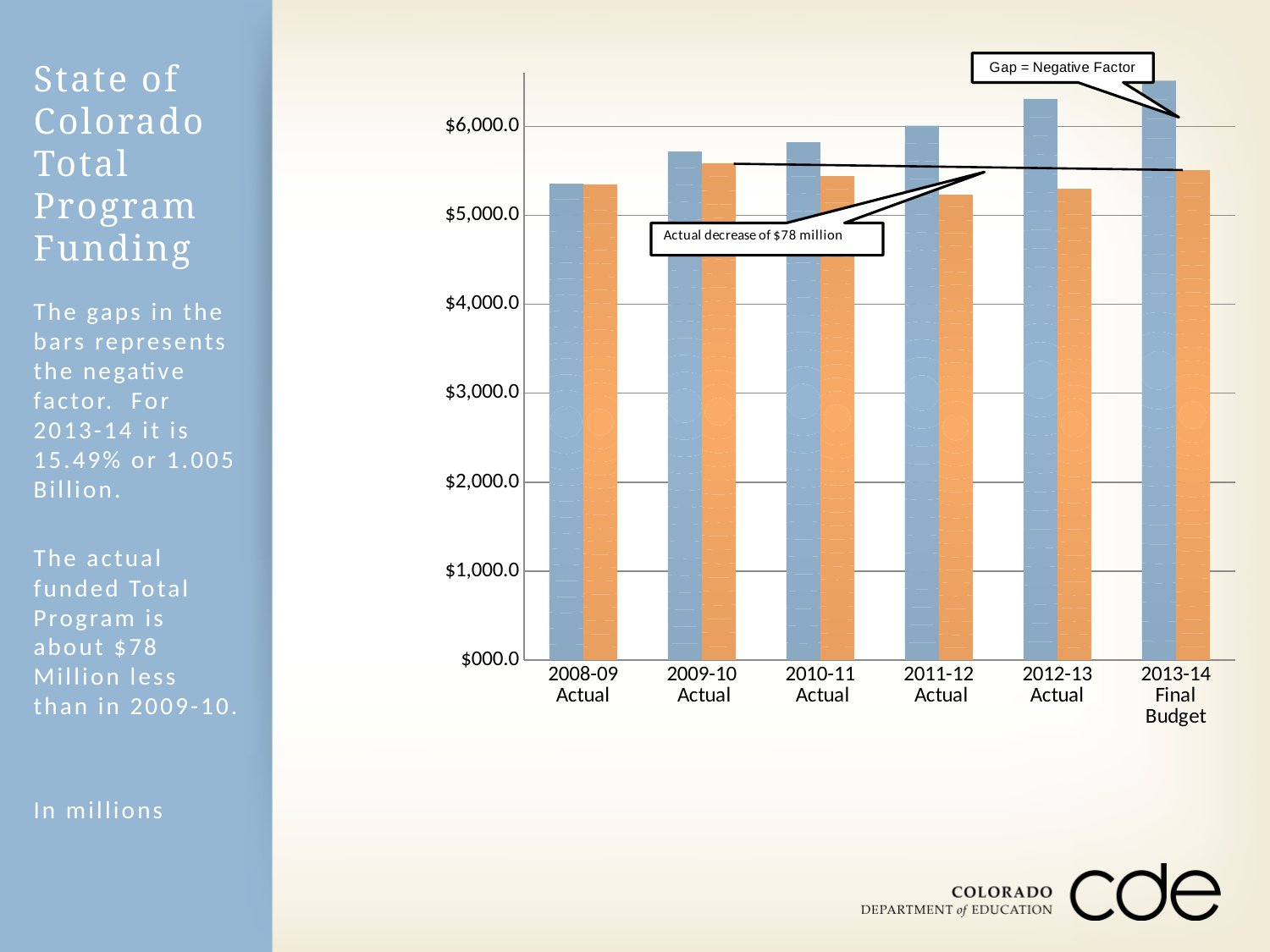
Which is larger in 2013-14 Final Budget, the blue bar or the orange bar? the blue bar Is the blue bar for 2008-09 Actual greater or less than $6,000.0? less Which fiscal year has the tallest blue bar in the chart? 2013-14 Final Budget What kind of chart is shown on the slide? bar chart Is the orange bar for 2008-09 Actual greater or less than $5,000.0? greater Which fiscal year has the shortest blue bar in the chart? 2008-09 Actual Is the orange bar for 2013-14 Final Budget greater or less than $6,000.0? less What actual decrease does the callout on the chart state? $78 million According to the callout on the chart, what does the gap between the bars represent? Negative Factor Do the blue bars rise or fall from 2008-09 Actual to 2013-14 Final Budget? rise How many fiscal-year categories are shown on the x axis of the chart? 6